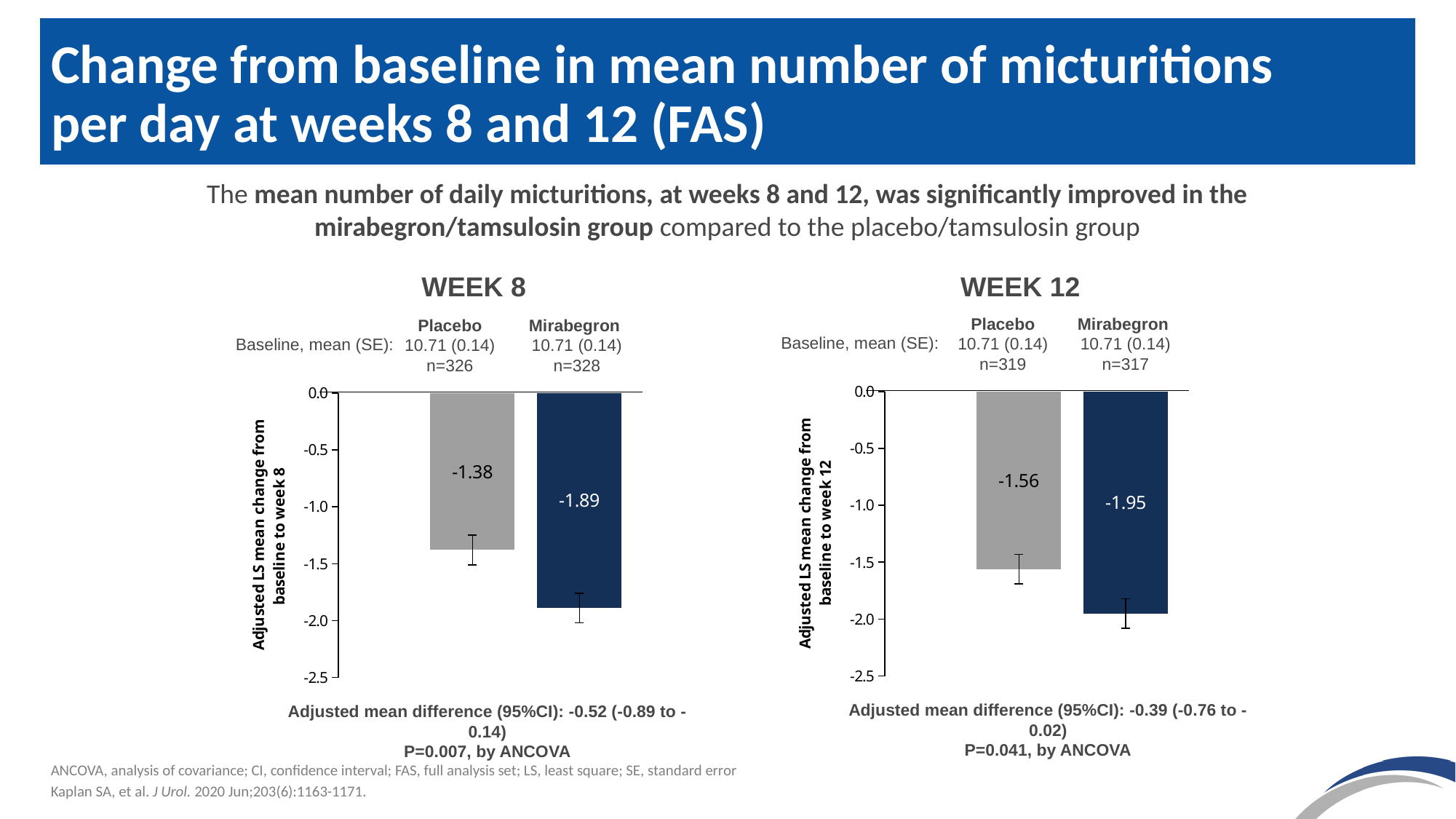
In the WEEK 8 chart, what is the P value reported for the adjusted mean difference? P=0.007 In the WEEK 12 chart, what is the adjusted LS mean change from baseline for Mirabegron? -1.95 In the WEEK 8 chart, what is the adjusted LS mean change from baseline for Placebo? -1.38 In the WEEK 8 chart, what is the adjusted LS mean change from baseline for Mirabegron? -1.89 What type of chart is used for the WEEK 12 data? Bar chart In the WEEK 8 chart, which group shows the larger reduction from baseline, Placebo or Mirabegron? Mirabegron How many bars are plotted in the WEEK 8 chart? 2 In the WEEK 12 chart, is the value for Placebo greater or less than -1.0? less In the WEEK 8 chart, what is the difference between the Mirabegron and Placebo values (-1.89 minus -1.38)? -0.51 In the WEEK 12 chart, what is the difference between the Mirabegron and Placebo values (-1.95 minus -1.56)? -0.39 In the WEEK 12 chart, what is the adjusted LS mean change from baseline for Placebo? -1.56 In the WEEK 12 chart, which group has the smallest change from baseline (closest to zero)? Placebo